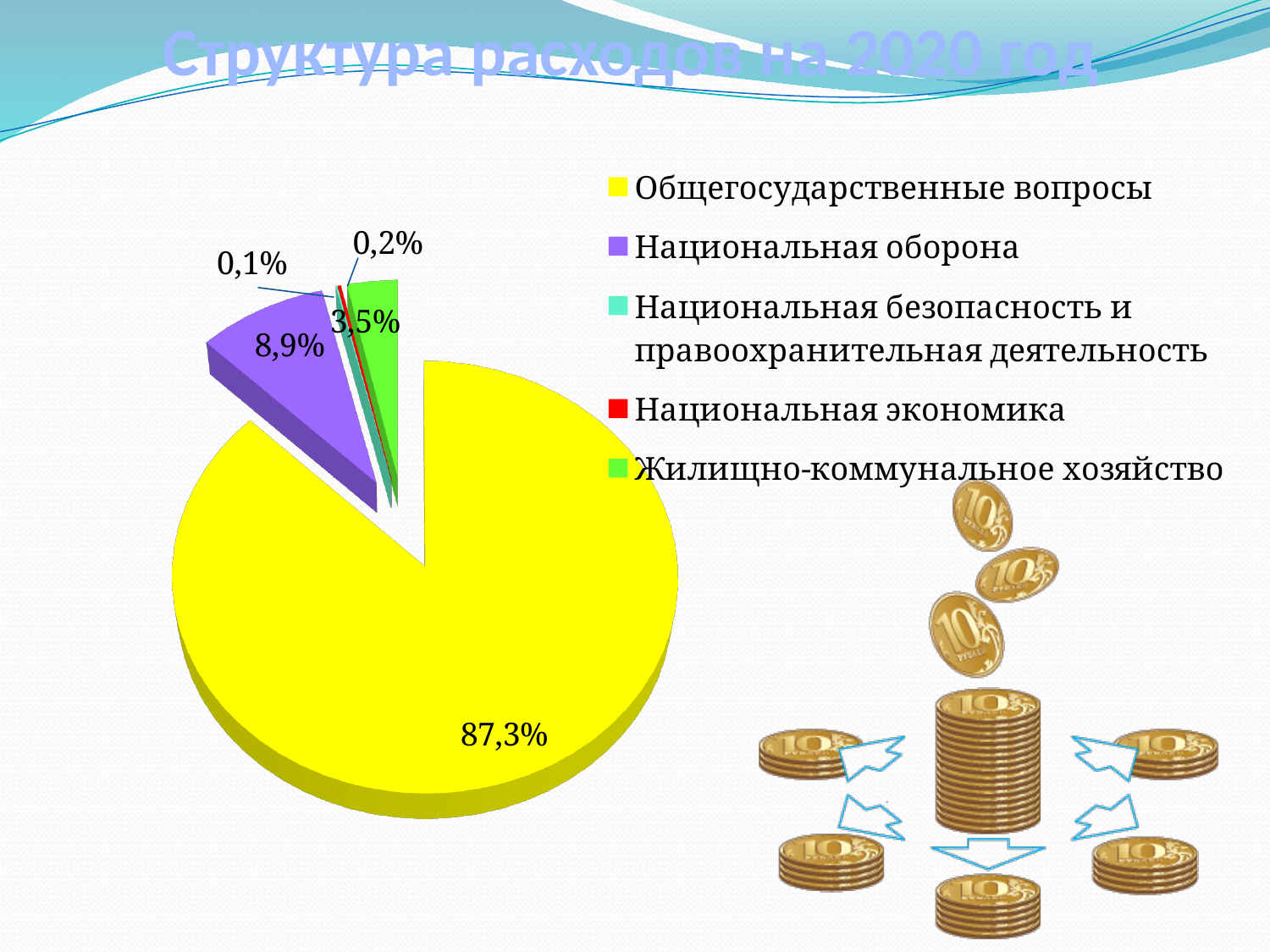
How many categories does the legend list? 5 What share of expenditures is Национальная экономика? 0,2% Which colour represents Национальная оборона in the chart? purple What share of expenditures is Национальная оборона? 8,9% What type of chart is shown on the slide? pie chart What is the title of the chart? Структура расходов на 2020 год What share of expenditures is Общегосударственные вопросы? 87,3% What is the difference in percentage points between Национальная оборона and Жилищно-коммунальное хозяйство? 5,4 What share of expenditures is Жилищно-коммунальное хозяйство? 3,5% Which category has the largest share of expenditures? Общегосударственные вопросы Which category has the smallest share of expenditures? Национальная безопасность и правоохранительная деятельность What share of expenditures is Национальная безопасность и правоохранительная деятельность? 0,1%